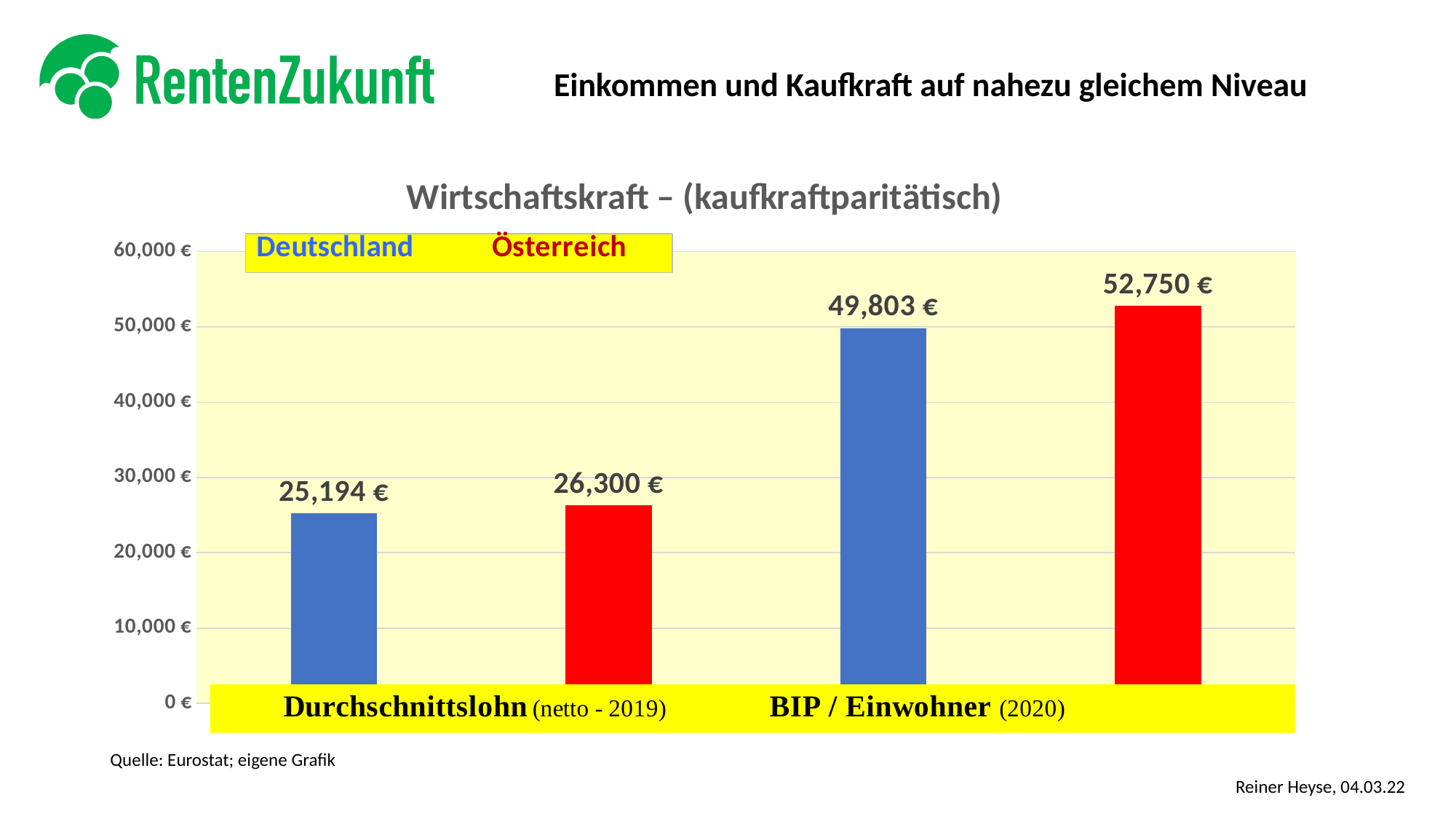
What is the value for Deutschland for Durchschnittslohn (netto - 2019)? 25,194 € What is the value for Deutschland for BIP / Einwohner (2020)? 49,803 € What is the difference between Österreich and Deutschland for BIP / Einwohner (2020)? 2,947 € Which bar has the lowest value in the chart? Deutschland, Durchschnittslohn (netto - 2019) Which bar has the highest value in the chart? Österreich, BIP / Einwohner (2020) How many series does the legend list? 2 What is the title of the chart? Wirtschaftskraft – (kaufkraftparitätisch) What is the value for Österreich for Durchschnittslohn (netto - 2019)? 26,300 € What is the difference between Österreich and Deutschland for Durchschnittslohn (netto - 2019)? 1,106 € What is the value for Österreich for BIP / Einwohner (2020)? 52,750 € Which is larger for Durchschnittslohn (netto - 2019): Deutschland or Österreich? Österreich What kind of chart is shown on the slide? Bar chart